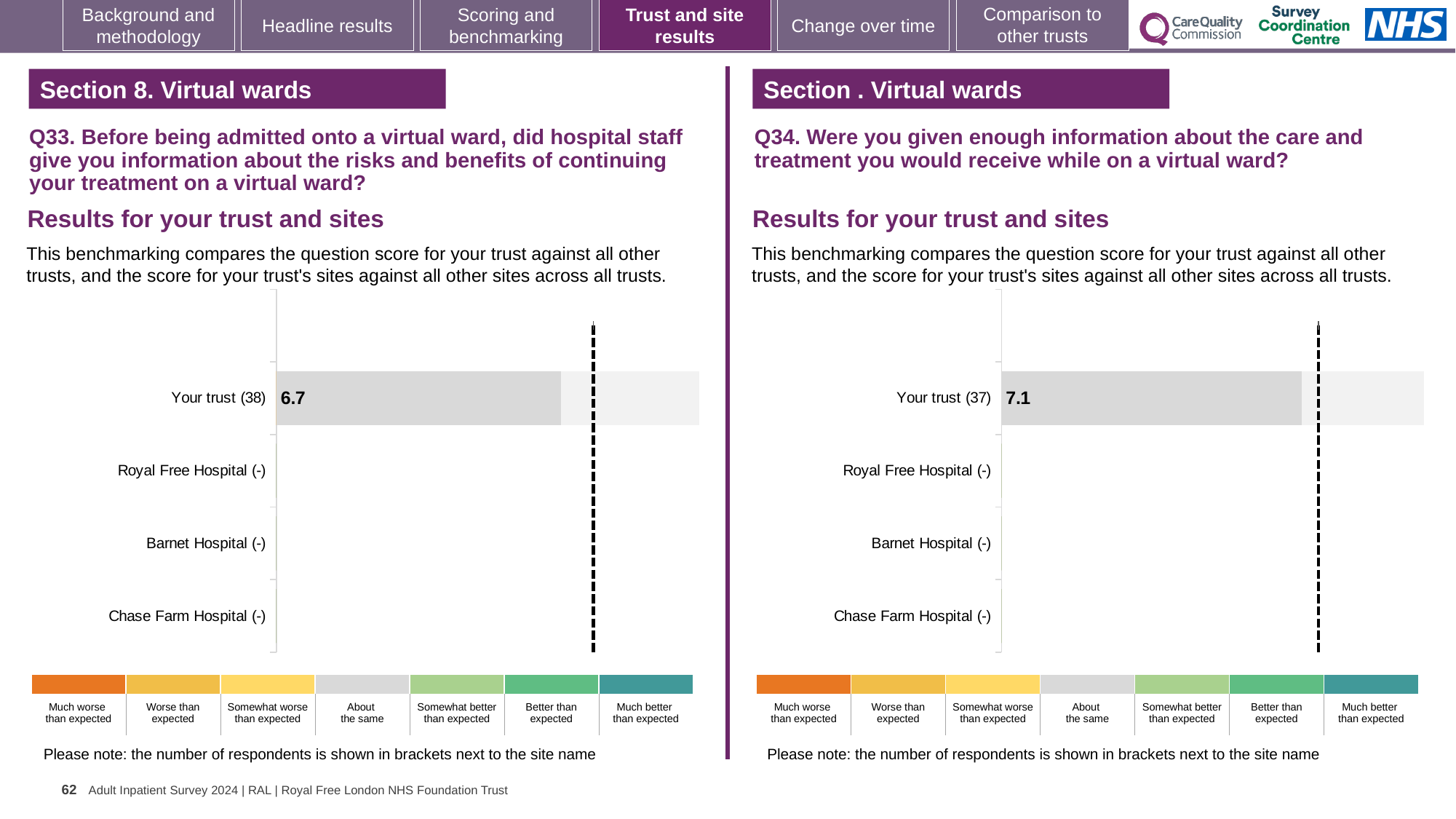
On the Q33 chart (left), which category has the highest score? Your trust (38) How many categories are listed on the y axis of the Q34 chart (right)? 4 Which is larger: the Your trust score on the Q33 chart (left) or on the Q34 chart (right)? Q34 chart (right) What is the difference between the Your trust score on the Q34 chart (right) and on the Q33 chart (left)? 0.4 What kind of chart is used on the Q33 chart (left)? Bar chart How many categories are listed on the y axis of the Q33 chart (left)? 4 On the Q33 chart (left), how many respondents are shown in brackets next to Your trust? 38 On the Q33 chart (left), what is the score for Your trust? 6.7 How many colour categories does the legend below the Q34 chart (right) list? 7 On the Q34 chart (right), how many respondents are shown in brackets next to Your trust? 37 On the Q34 chart (right), what is the score for Your trust? 7.1 On the Q33 chart (left), which category is listed last on the y axis? Chase Farm Hospital (-)